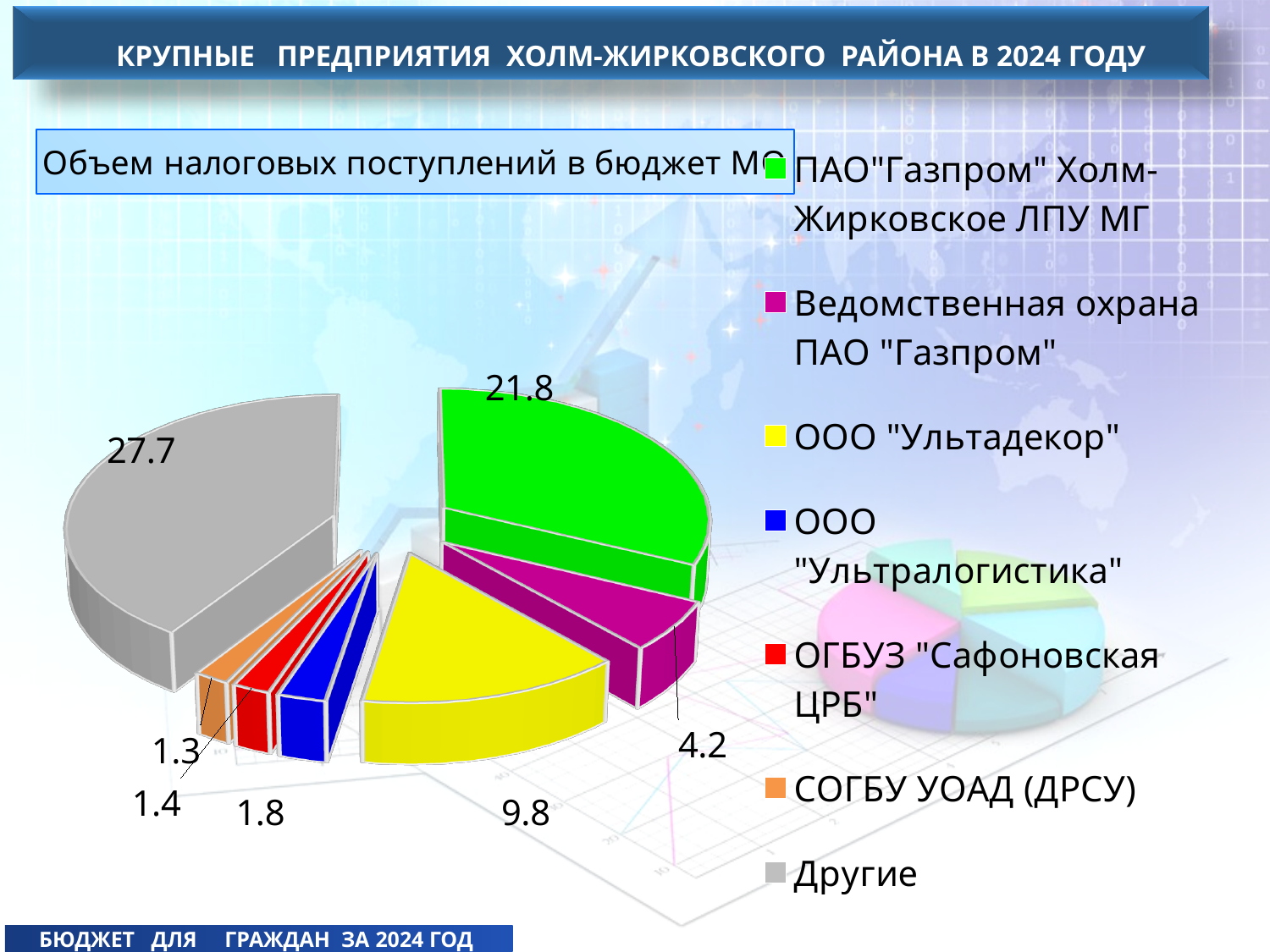
What kind of chart is shown on the slide? Pie chart What is the value for ООО "Ультралогистика"? 1.8 What is the value for ПАО "Газпром" Холм-Жирковское ЛПУ МГ? 21.8 What is the value for Ведомственная охрана ПАО "Газпром"? 4.2 What is the difference between the values for Другие and ПАО "Газпром" Холм-Жирковское ЛПУ МГ? 5.9 What is the value for Другие? 27.7 What is the value for ООО "Ультадекор"? 9.8 Which is larger, the value for ООО "Ультадекор" or the value for Ведомственная охрана ПАО "Газпром"? ООО "Ультадекор" Which category has the largest slice of the pie? Другие Which category has the smallest slice of the pie? СОГБУ УОАД (ДРСУ) How many categories does the legend list? 7 What colour is the slice for ОГБУЗ "Сафоновская ЦРБ"? Red